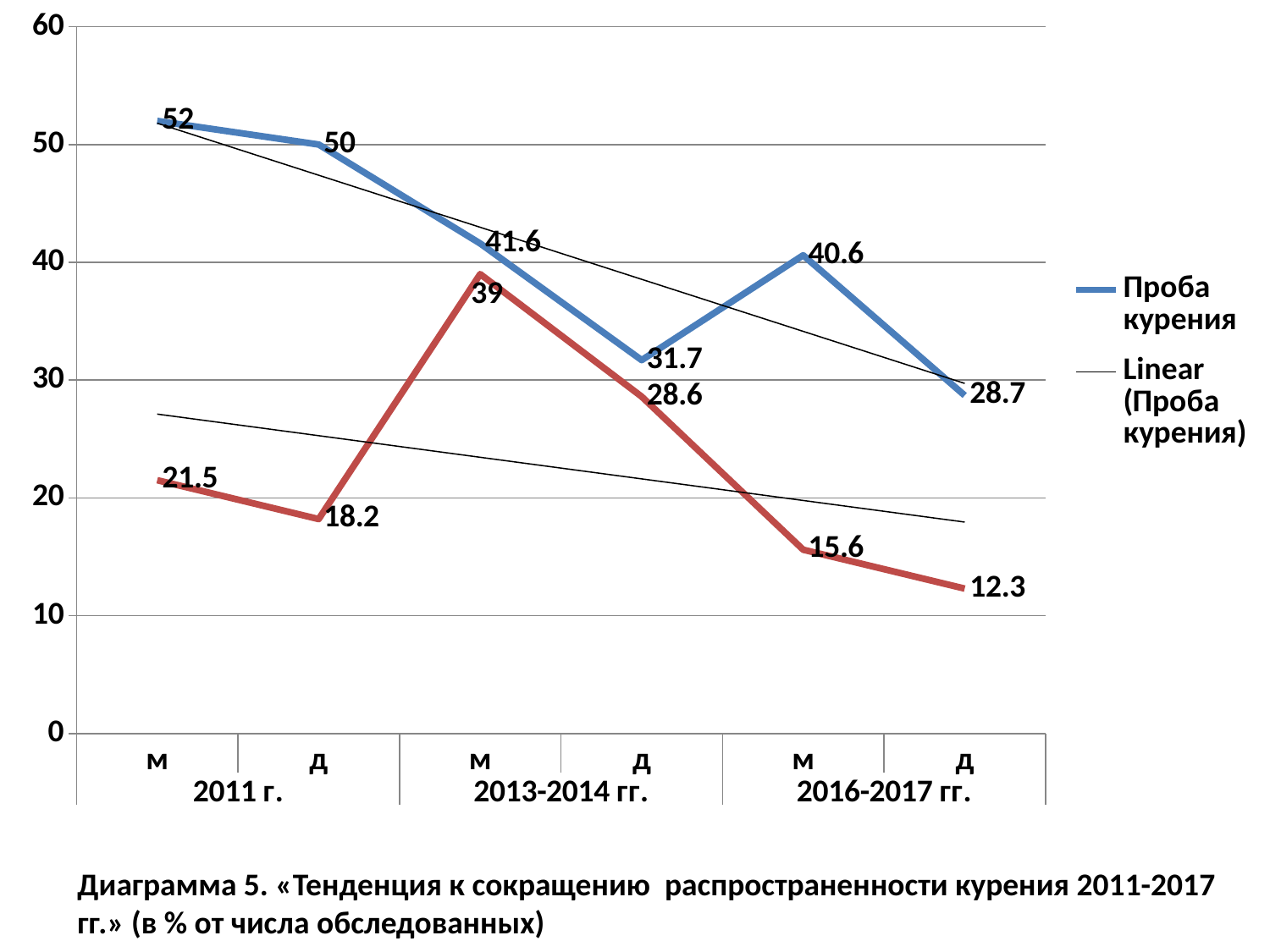
At which point does the red line reach its lowest value? д, 2016-2017 гг. How many data points does the Проба курения series have? 6 What is the value of the Проба курения series for д in 2016-2017 гг.? 28.7 How many entries does the legend list? 2 Which is larger for the Проба курения series: the value for д in 2013-2014 гг. or the value for м in 2016-2017 гг.? м in 2016-2017 гг. What is the value of the red line for м in 2013-2014 гг.? 39 What kind of chart is shown on the slide? Line chart What is the difference between the red line values for м and д in 2013-2014 гг.? 10.4 What is the value of the Проба курения series for м in 2011 г.? 52 Does the red line rise or fall from м in 2016-2017 гг. to д in 2016-2017 гг.? Fall At which point does the Проба курения series reach its highest value? м, 2011 г. What is the difference between the Проба курения values for м and д in 2011 г.? 2